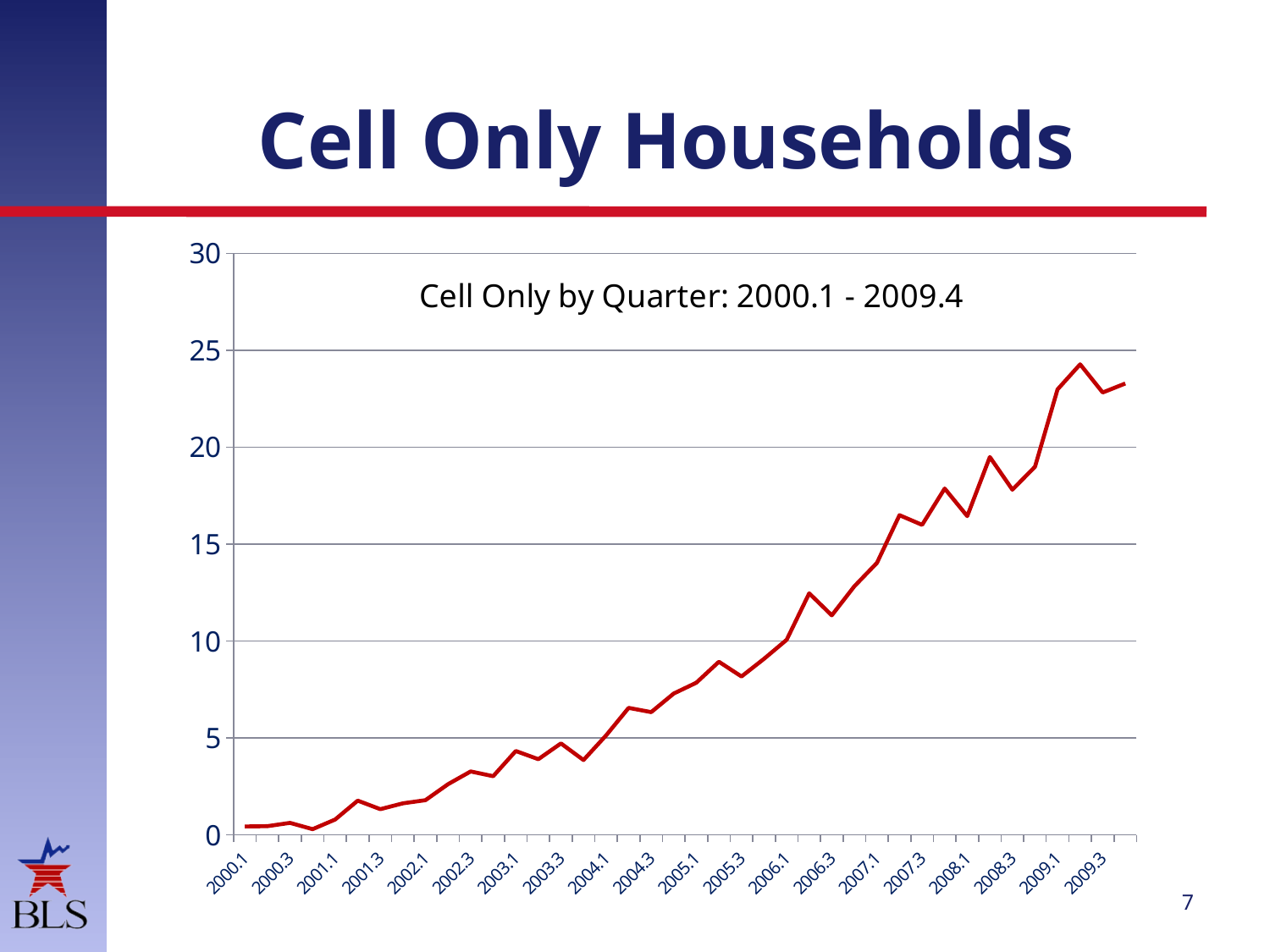
Do the values generally rise or fall from 2000.1 to 2009.3 along the x axis? rise Which has the larger value, 2008.1 or 2006.1? 2008.1 Is the value for 2009.3 greater or less than 20? greater What colour is the line in the chart? red What is the title printed inside the chart area? Cell Only by Quarter: 2000.1 - 2009.4 Is the value for 2005.1 greater or less than 10? less Is the value for 2002.1 greater or less than 5? less What kind of chart is shown on the slide? line chart